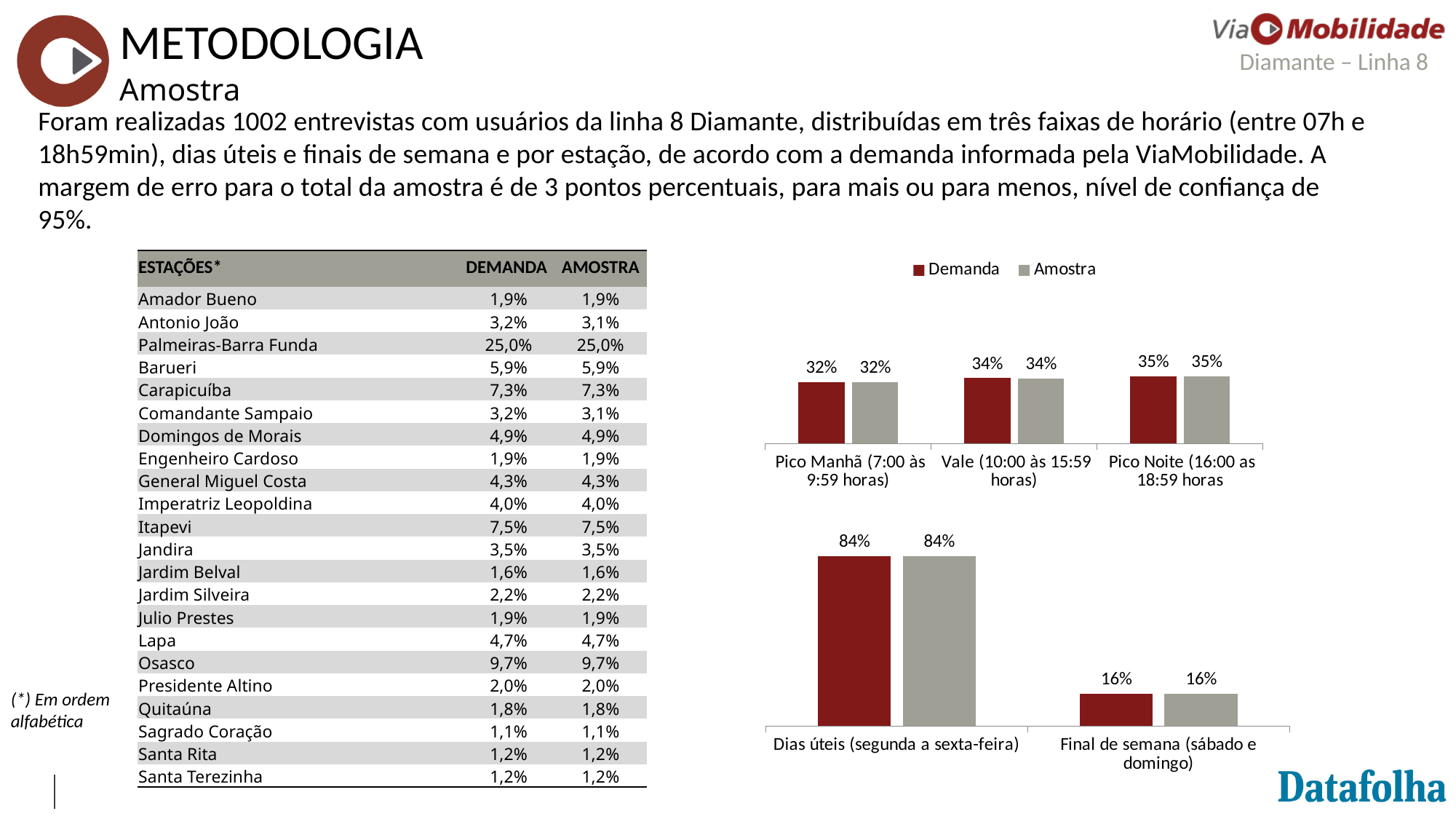
In the top chart, which time band has the highest Demanda value? Pico Noite (16:00 as 18:59 horas) In the top chart, how many time bands are shown on the x axis? 3 In the top chart, what is the Demanda value for Pico Manhã (7:00 às 9:59 horas)? 32% In the top chart, what is the Demanda value for Pico Noite (16:00 as 18:59 horas)? 35% In the bottom chart, what is the Demanda value for Final de semana (sábado e domingo)? 16% How many series does the legend of the top chart list? 2 In the top chart, what is the Amostra value for Vale (10:00 às 15:59 horas)? 34% In the top chart, which time band has the lowest Amostra value? Pico Manhã (7:00 às 9:59 horas) In the bottom chart, which is larger: the Amostra value for Dias úteis or for Final de semana? Dias úteis In the bottom chart, what is the difference between the Demanda values for Dias úteis and Final de semana? 68 percentage points In the bottom chart, what is the Amostra value for Dias úteis (segunda a sexta-feira)? 84% In the top chart, what is the difference between the Demanda values for Pico Noite and Pico Manhã? 3 percentage points